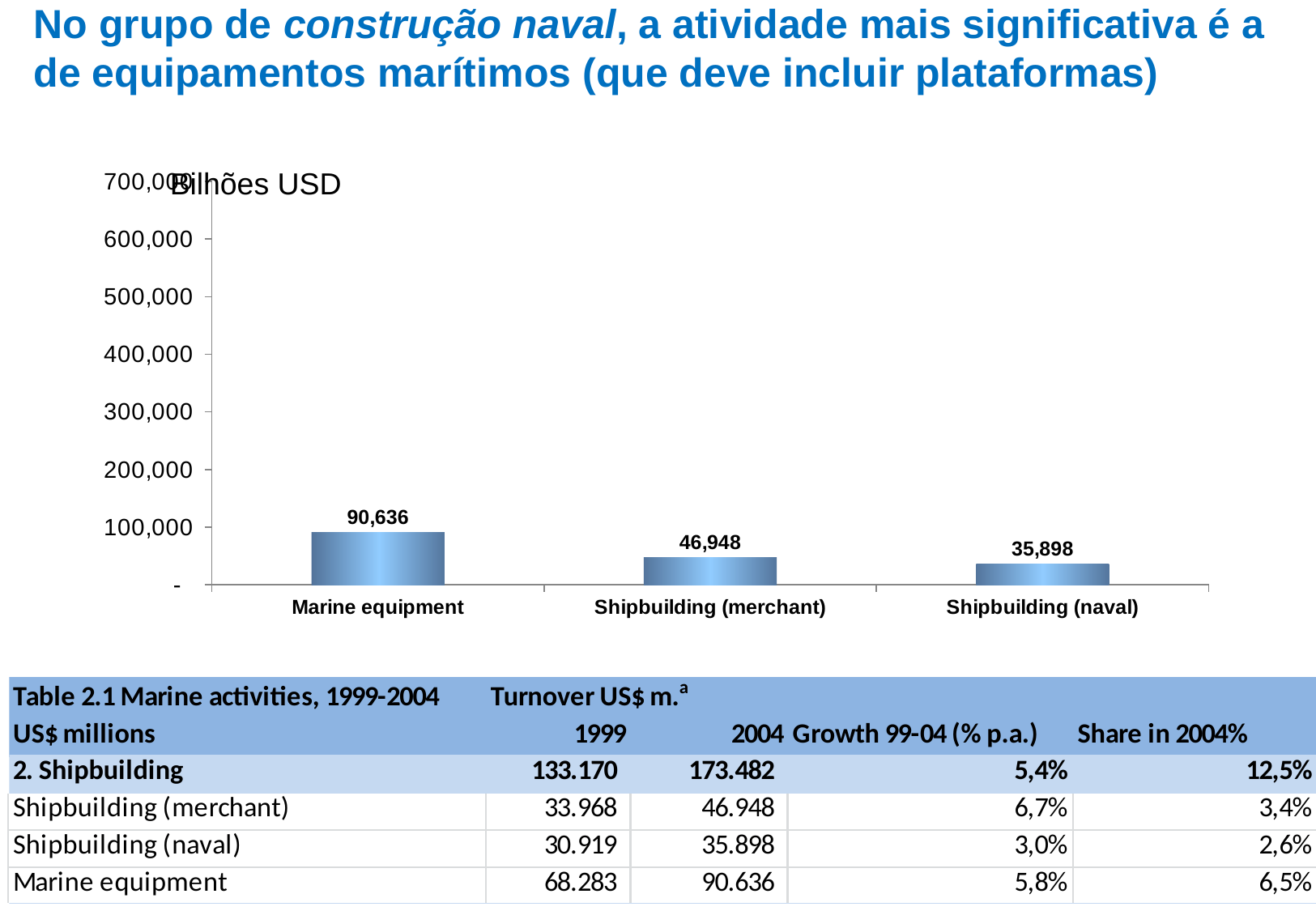
Which category has the highest value? Marine equipment What unit label is shown at the top of the chart? Bilhões USD What is the difference between the values for Marine equipment and Shipbuilding (merchant)? 43,688 Is the value for Marine equipment greater or less than 100,000? less Which is larger, the value for Shipbuilding (merchant) or Shipbuilding (naval)? Shipbuilding (merchant) What is the difference between the values for Shipbuilding (merchant) and Shipbuilding (naval)? 11,050 What is the value for Shipbuilding (naval)? 35,898 How many categories are shown in the chart? 3 What is the value for Marine equipment? 90,636 What is the value for Shipbuilding (merchant)? 46,948 Which category has the lowest value? Shipbuilding (naval) What kind of chart is shown on the slide? bar chart